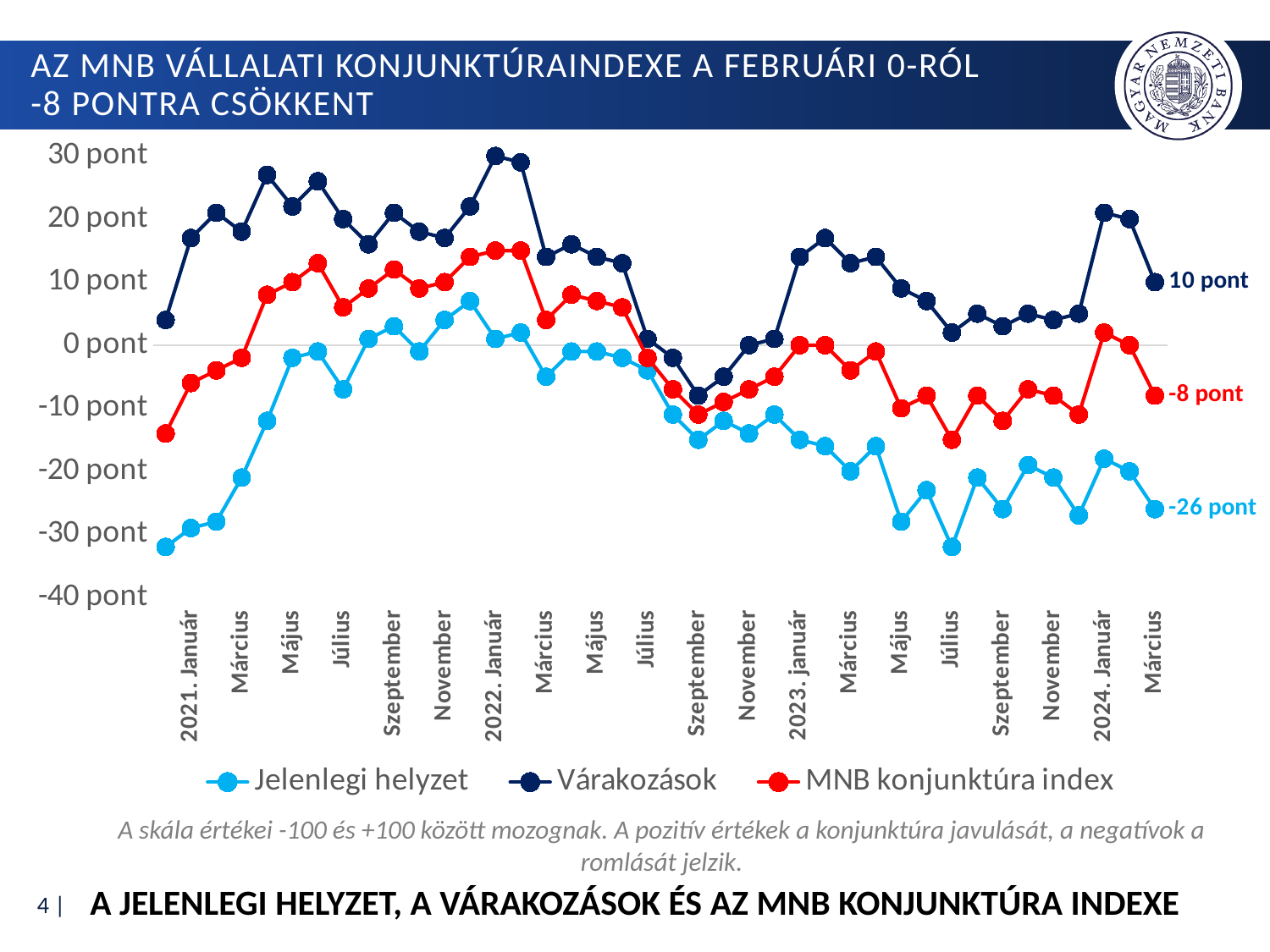
What is the value of the Jelenlegi helyzet series at the last point (Március 2024)? -26 pont How many series does the legend list? 3 What type of chart is shown on the slide? line chart Is the value of Várakozások in 2022. Január greater or less than 20 pont? greater Which series has the lowest value at the last point (Március 2024)? Jelenlegi helyzet What colour is the line for the MNB konjunktúra index series? red Which series has the highest value at the last point (Március 2024)? Várakozások At the last point (Március 2024), which is larger: the Várakozások value or the Jelenlegi helyzet value? Várakozások What is the value of the MNB konjunktúra index at the last point (Március 2024)? -8 pont What is the difference between the Várakozások value and the MNB konjunktúra index value at the last point (Március 2024)? 18 pont What is the value of the Várakozások series at the last point (Március 2024)? 10 pont